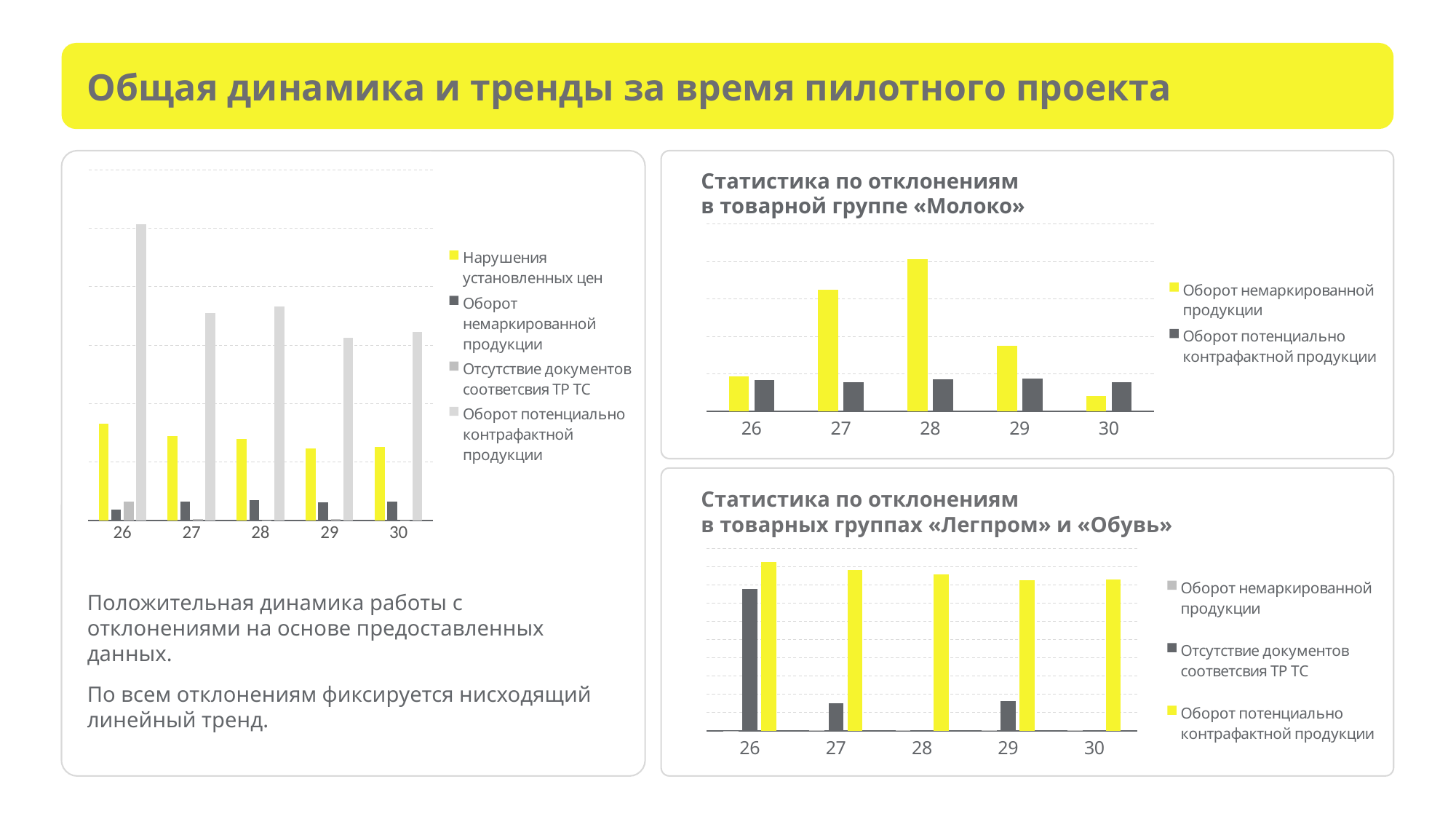
In the chart on the left side of the slide, does «Нарушения установленных цен» generally rise or fall from 26 to 30? fall How many series does the legend list for the chart titled «Статистика по отклонениям в товарных группах «Легпром» и «Обувь»»? 3 In the chart on the left side of the slide, at which x-axis category is «Отсутствие документов соответсвия ТР ТС» highest? 26 How many categories are shown on the x axis of the chart titled «Статистика по отклонениям в товарной группе «Молоко»»? 5 In the chart titled «Статистика по отклонениям в товарных группах «Легпром» и «Обувь»», which is larger at category 28: «Отсутствие документов соответсвия ТР ТС» or «Оборот потенциально контрафактной продукции»? Оборот потенциально контрафактной продукции In the chart titled «Статистика по отклонениям в товарных группах «Легпром» и «Обувь»», at which x-axis category is «Отсутствие документов соответсвия ТР ТС» highest? 26 In the chart titled «Статистика по отклонениям в товарной группе «Молоко»», at which x-axis category is «Оборот немаркированной продукции» lowest? 30 In the chart titled «Статистика по отклонениям в товарной группе «Молоко»», which is larger at category 27: «Оборот немаркированной продукции» or «Оборот потенциально контрафактной продукции»? Оборот немаркированной продукции How many series does the legend list for the chart on the left side of the slide? 4 In the chart titled «Статистика по отклонениям в товарной группе «Молоко»», what colour are the bars for «Оборот немаркированной продукции»? yellow What kind of chart is the chart titled «Статистика по отклонениям в товарной группе «Молоко»»? bar chart In the chart titled «Статистика по отклонениям в товарной группе «Молоко»», at which x-axis category is «Оборот немаркированной продукции» highest? 28